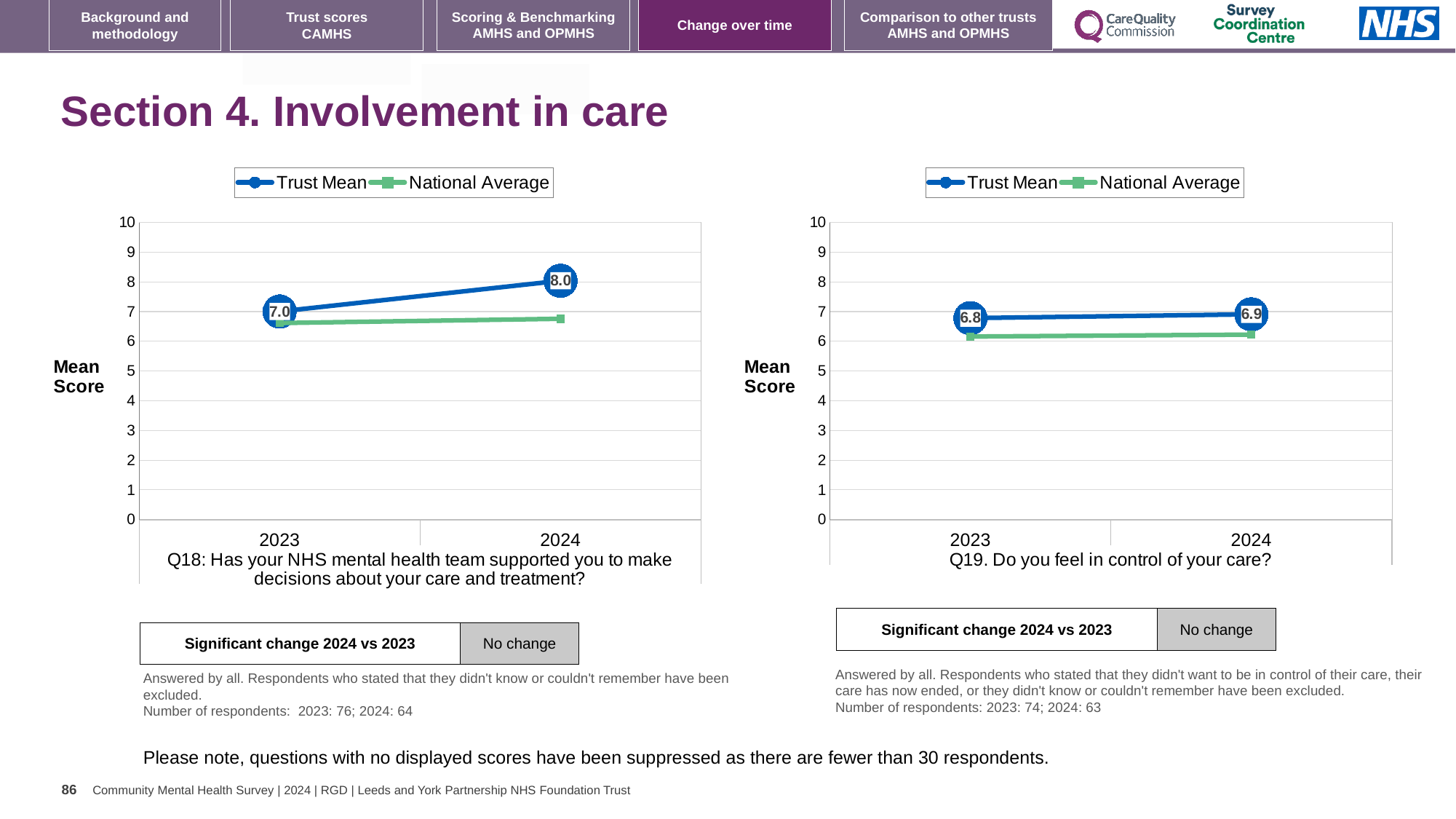
In the Q18 chart (left), by how much did the Trust Mean change from 2023 to 2024? 1.0 In the Q19 chart (right), which is higher in 2023, the Trust Mean or the National Average? Trust Mean What are the two series named in the legend of the Q19 chart (right)? Trust Mean and National Average In the Q18 chart (left), is the National Average value for 2023 greater or less than 7? less In the Q19 chart (right), what is the Trust Mean score for 2023? 6.8 In the Q18 chart (left), does the Trust Mean rise or fall from 2023 to 2024? rise How many years are plotted on the x axis of the Q19 chart (right)? 2 What kind of chart is the Q19 chart (right)? line chart In the Q18 chart (left), what is the Trust Mean score for 2023? 7.0 How many series does the legend of the Q18 chart (left) list? 2 In the Q19 chart (right), what is the Trust Mean score for 2024? 6.9 In the Q18 chart (left), what is the Trust Mean score for 2024? 8.0